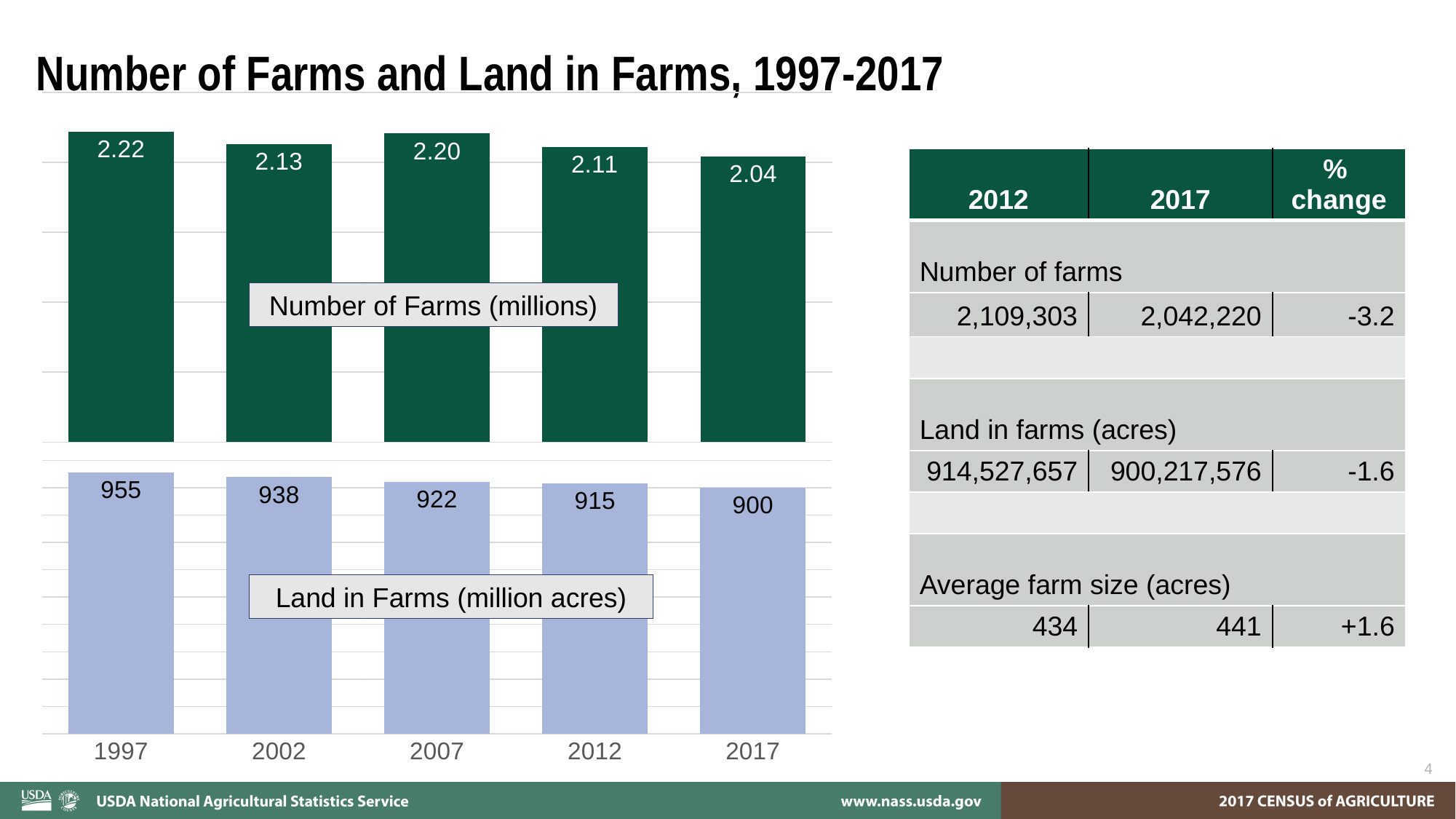
In the Land in Farms (million acres) chart, what is the value for 2012? 915 In the Land in Farms (million acres) chart, which year has the lowest value? 2017 What colour are the bars in the Number of Farms (millions) chart? dark green In the Land in Farms (million acres) chart, what is the difference between the 1997 and 2017 values? 55 What kind of chart is the Land in Farms (million acres) chart? bar chart How many years are shown on the x axis of the Land in Farms (million acres) chart? 5 In the Number of Farms (millions) chart, which is larger, the value for 2002 or the value for 2007? 2007 In the Number of Farms (millions) chart, what is the value for 2007? 2.20 In the Number of Farms (millions) chart, which year has the highest value? 1997 In the Number of Farms (millions) chart, what is the difference between the 2012 and 2017 values? 0.07 In the Number of Farms (millions) chart, which year has the lowest value? 2017 In the Land in Farms (million acres) chart, do the values rise or fall from 1997 to 2017? fall